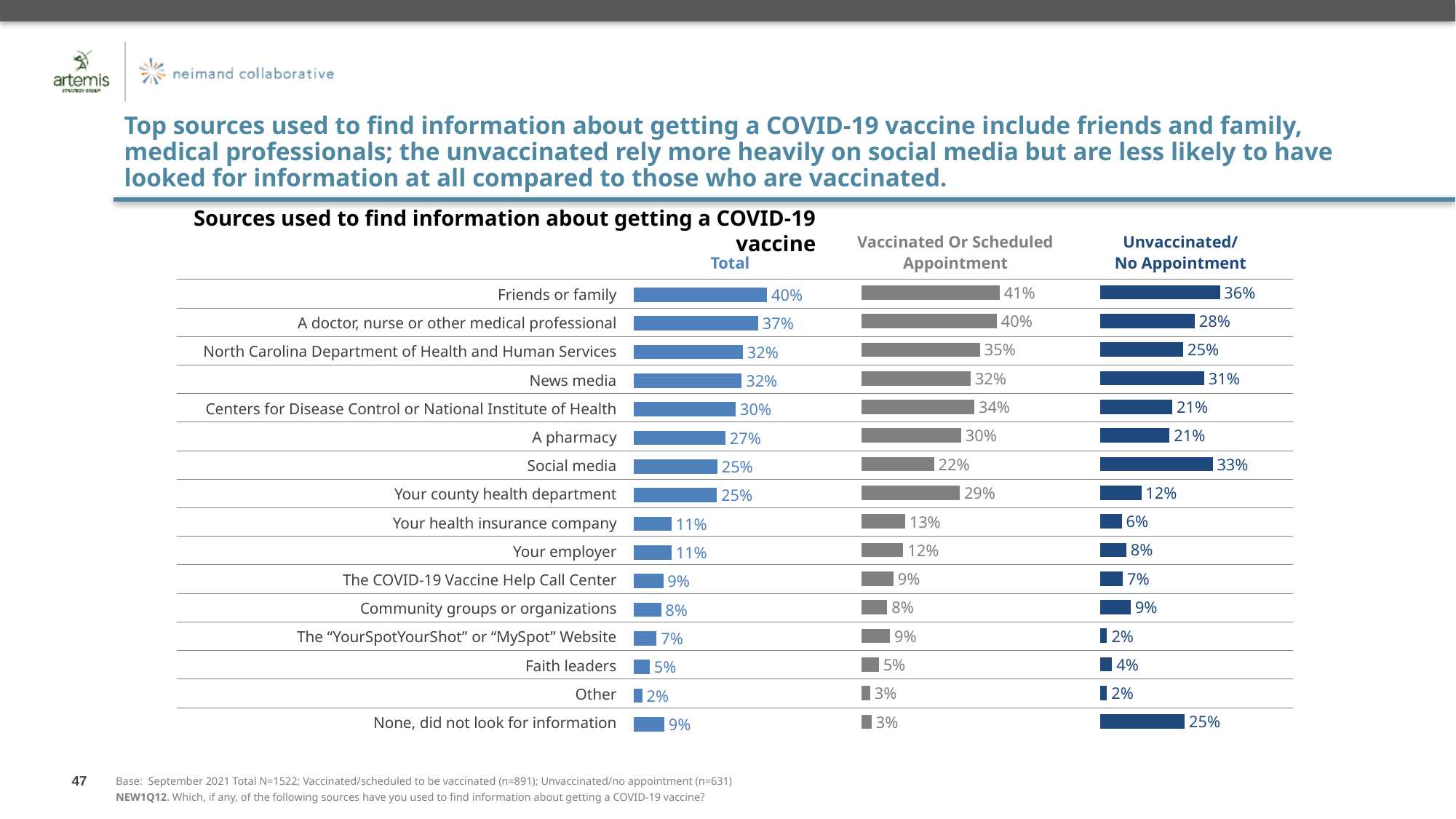
In the Unvaccinated/No Appointment chart, what is the value for social media? 33% What type of chart is used to display the data on this slide? Bar chart For social media, which group has the larger value: Vaccinated Or Scheduled Appointment or Unvaccinated/No Appointment? Unvaccinated/No Appointment In the Total chart, what percentage of respondents used friends or family as a source of information? 40% In the Total chart, which category has the lowest value? Other How many source categories are listed in the charts? 16 In the Unvaccinated/No Appointment chart, which source has the highest value? Friends or family In the Vaccinated Or Scheduled Appointment chart, what is the difference between friends or family and social media? 19 percentage points In the Vaccinated Or Scheduled Appointment chart, what is the value for a pharmacy? 30% How many respondent groups (columns of bars) are shown on the slide? 3 What is the difference between the Unvaccinated/No Appointment and Vaccinated Or Scheduled Appointment values for 'None, did not look for information'? 22 percentage points What is the title of the chart on the slide? Sources used to find information about getting a COVID-19 vaccine